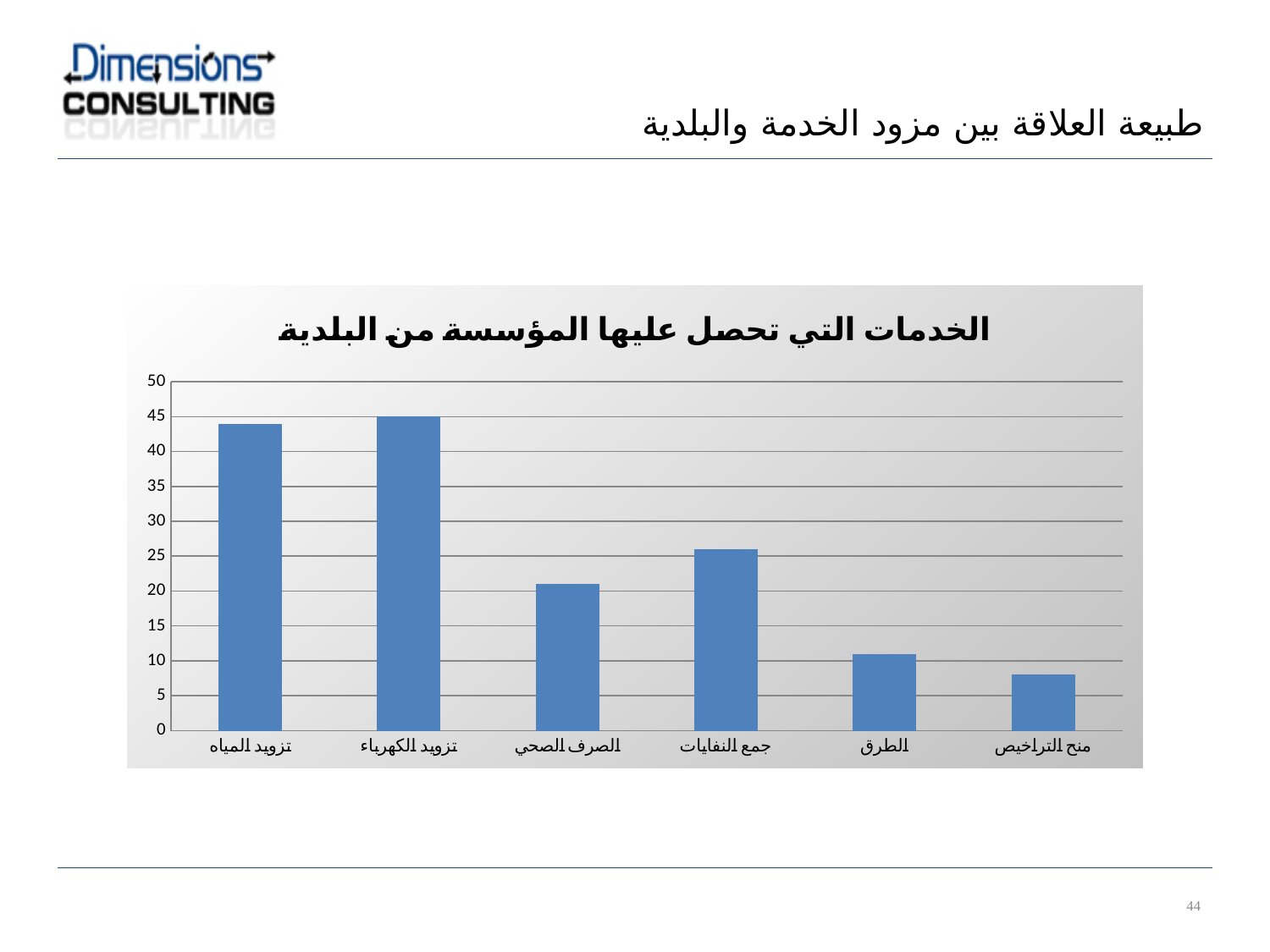
What type of chart is shown on the slide? bar chart Which is larger, the value for جمع النفايات or the value for الصرف الصحي? جمع النفايات Which category has the lowest value? منح التراخيص How many categories are shown on the x axis of the chart? 6 What is the value for تزويد الكهرباء? 45 What is the title of the chart? الخدمات التي تحصل عليها المؤسسة من البلدية Is the value for تزويد المياه greater or less than 40? greater Which is larger, the value for الطرق or the value for منح التراخيص? الطرق Is the value for منح التراخيص greater or less than 10? less